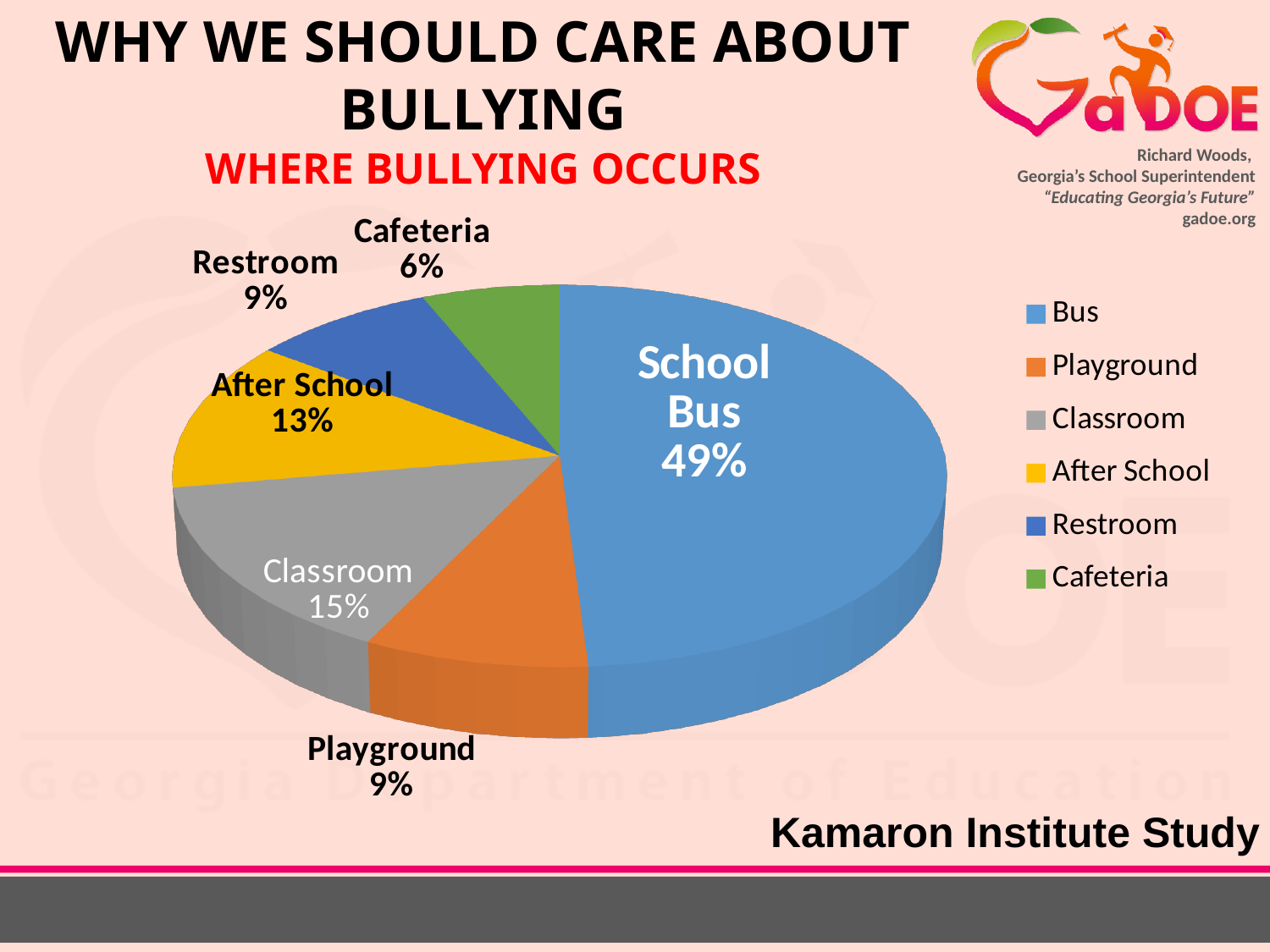
What percentage of bullying occurs in the cafeteria? 6% Which location has the smallest share of bullying? Cafeteria What percentage of bullying occurs in the classroom? 15% What percentage of bullying occurs on the school bus? 49% How many locations are shown in the pie chart? 6 What is the combined share of Restroom and Playground? 18% What is the difference between the Classroom share and the Cafeteria share? 9% What kind of chart is shown on the slide? Pie chart What colour represents the Classroom slice? Gray Which has a larger share, After School or Restroom? After School Which location has the largest share of bullying? School Bus What percentage of bullying occurs after school? 13%